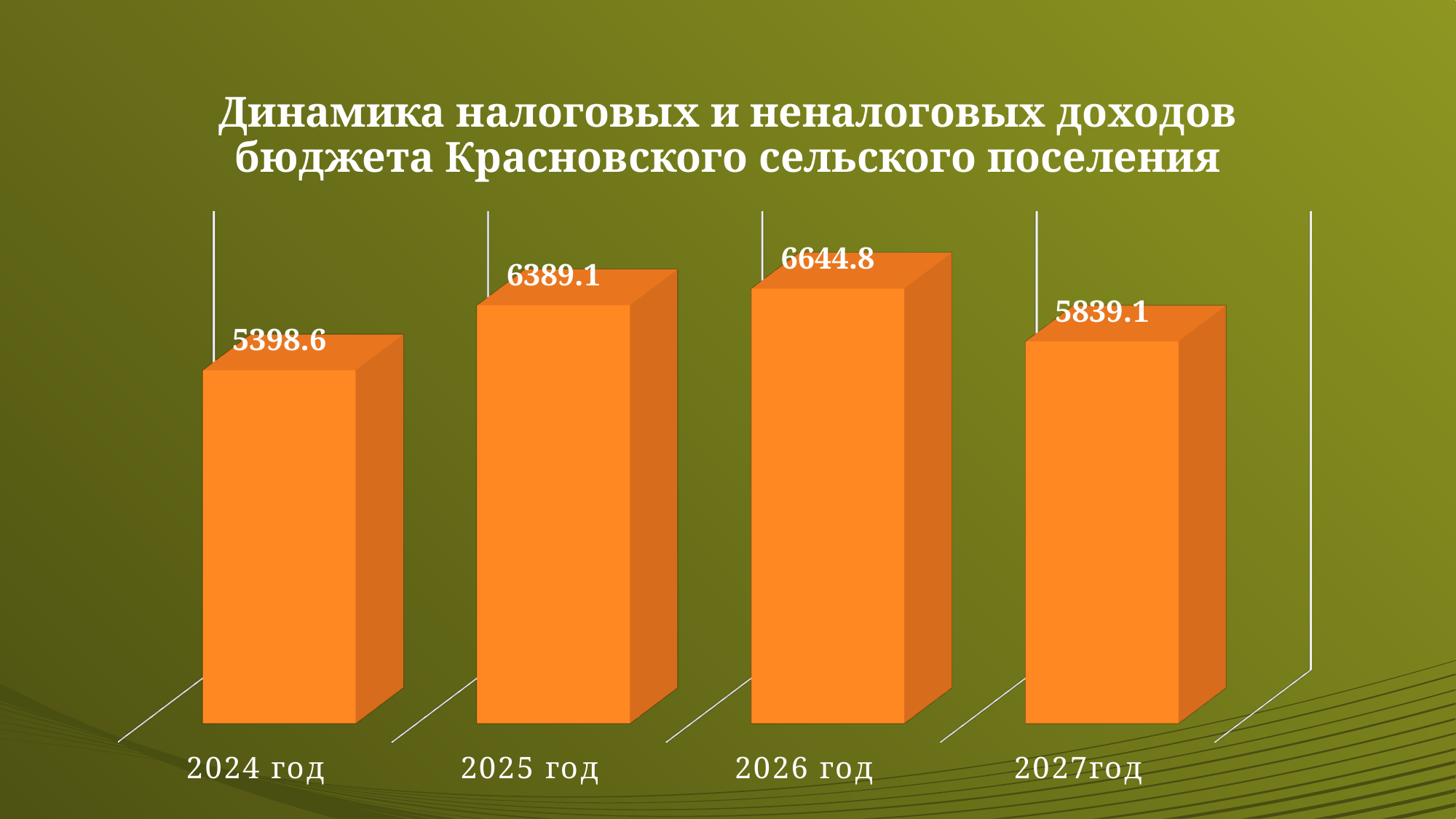
What is the value for 2024 год? 5398.6 What is the title of the chart? Динамика налоговых и неналоговых доходов бюджета Красновского сельского поселения Which year has the lowest value? 2024 год What is the value for 2027год? 5839.1 How many years are shown on the chart? 4 Which year has the highest value? 2026 год Which is larger, the value for 2025 год or the value for 2027год? 2025 год What is the value for 2025 год? 6389.1 What is the value for 2026 год? 6644.8 What is the difference between the values for 2027год and 2024 год? 440.5 What kind of chart is shown on the slide? bar chart What is the difference between the values for 2026 год and 2025 год? 255.7